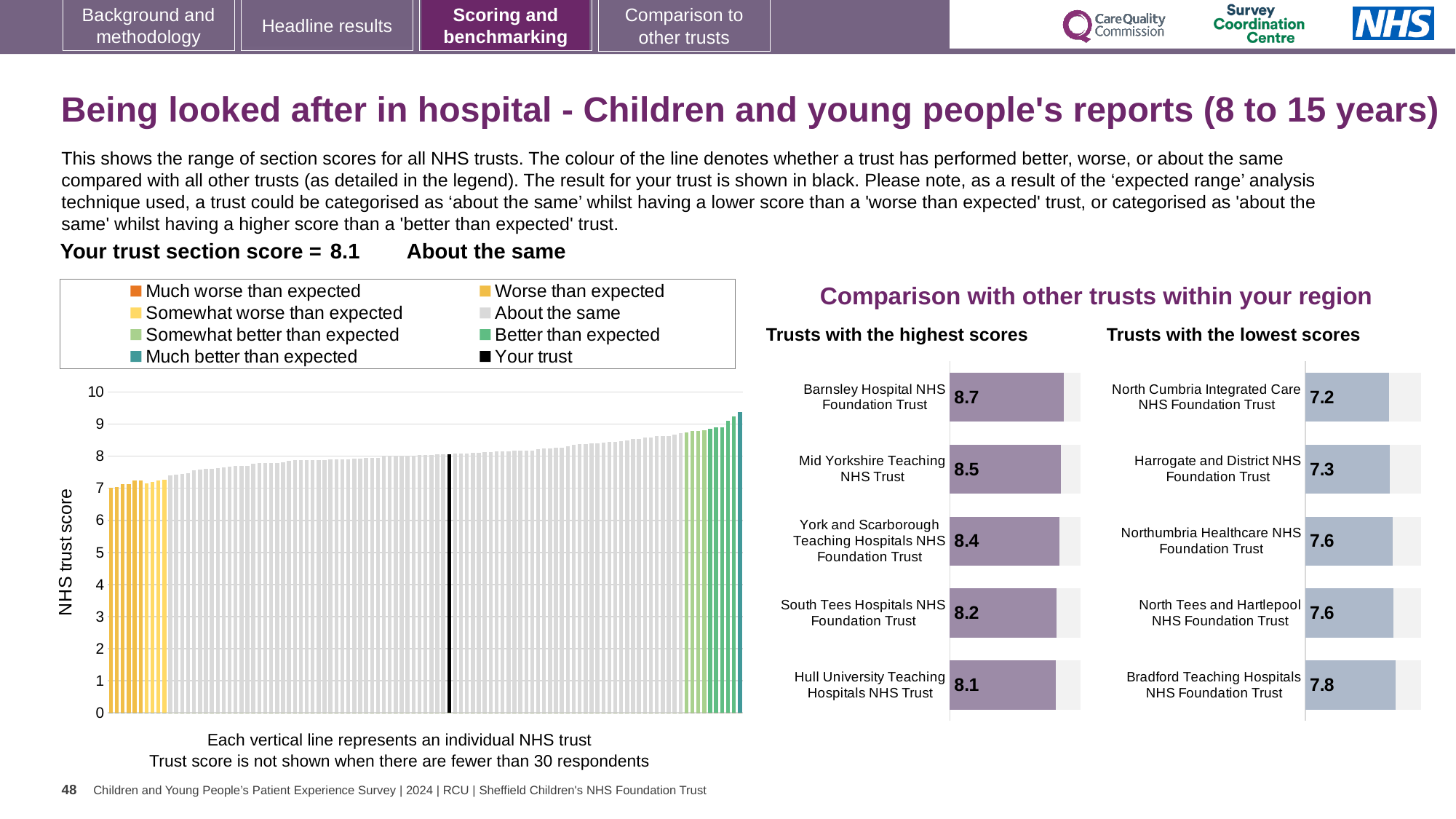
In the 'Trusts with the lowest scores' chart, which trust has the lowest score? North Cumbria Integrated Care NHS Foundation Trust What kind of chart is the large chart on the left showing NHS trust scores? Bar chart In the 'Trusts with the highest scores' chart, what is the difference between the scores of Barnsley Hospital NHS Foundation Trust and Hull University Teaching Hospitals NHS Trust? 0.6 In the 'Trusts with the highest scores' chart, which trust has the highest score? Barnsley Hospital NHS Foundation Trust How many trusts are shown in the 'Trusts with the highest scores' chart? 5 In the large chart on the left, is the value for your trust (the black line) greater or less than 8? greater How many entries does the legend above the large chart on the left list? 8 In the large chart on the left, do the trust scores rise or fall from left to right? Rise In the 'Trusts with the lowest scores' chart, what is the score for Northumbria Healthcare NHS Foundation Trust? 7.6 In the 'Trusts with the highest scores' chart, what is the score for Hull University Teaching Hospitals NHS Trust? 8.1 In the 'Trusts with the highest scores' chart, what is the score for Barnsley Hospital NHS Foundation Trust? 8.7 In the 'Trusts with the lowest scores' chart, which has the larger score: Harrogate and District NHS Foundation Trust or Bradford Teaching Hospitals NHS Foundation Trust? Bradford Teaching Hospitals NHS Foundation Trust